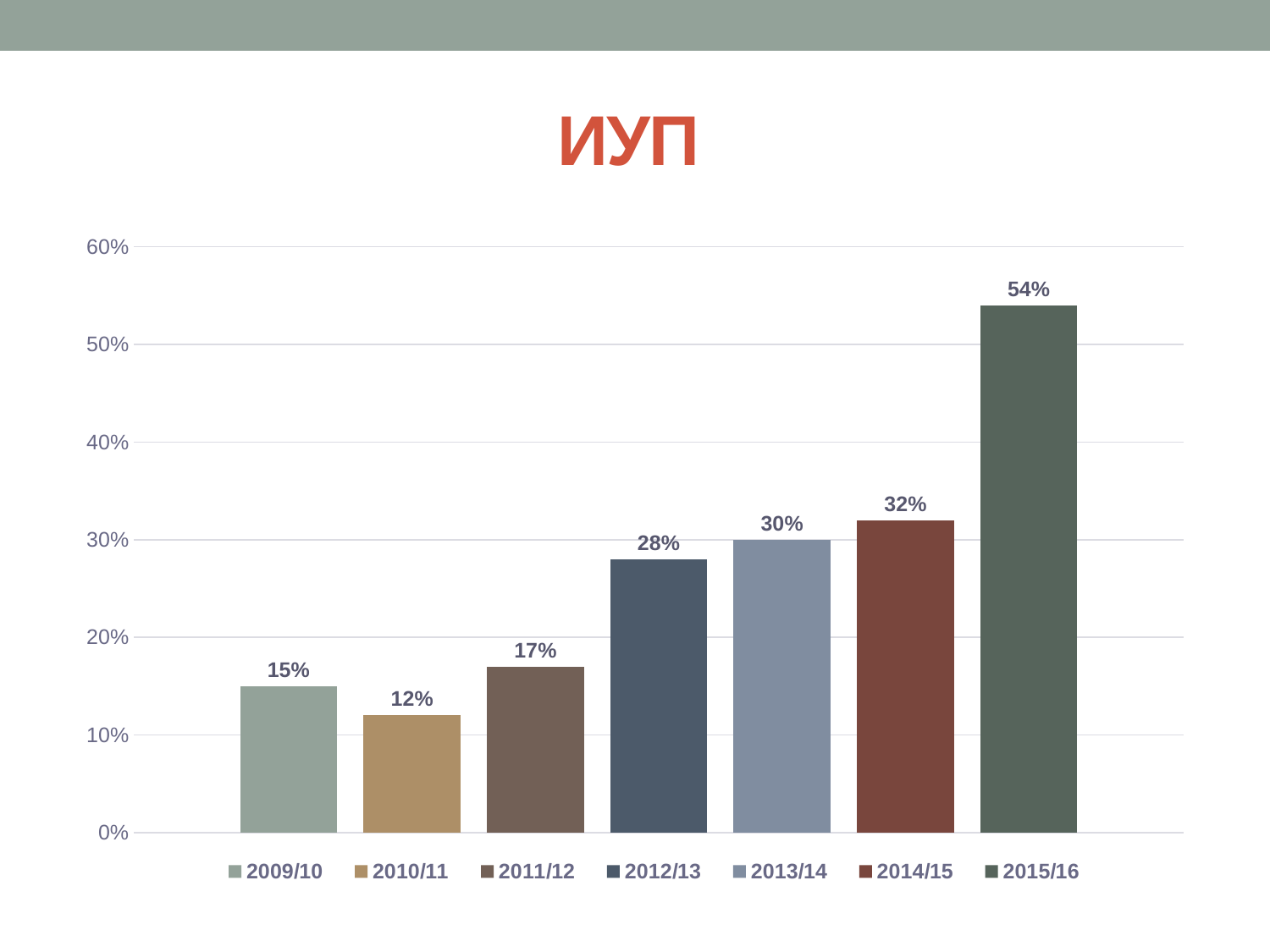
Which year has the highest value? 2015/16 What is the value for 2015/16? 54% What kind of chart is shown on the slide? Bar chart What is the difference between the values for 2011/12 and 2010/11? 5% What is the difference between the values for 2015/16 and 2014/15? 22% What is the value for 2010/11? 12% How many bars are shown in the chart? 7 How many entries does the legend list? 7 What is the title of the chart? ИУП What is the value for 2012/13? 28% Which is larger, the value for 2009/10 or the value for 2011/12? 2011/12 Which year has the lowest value? 2010/11